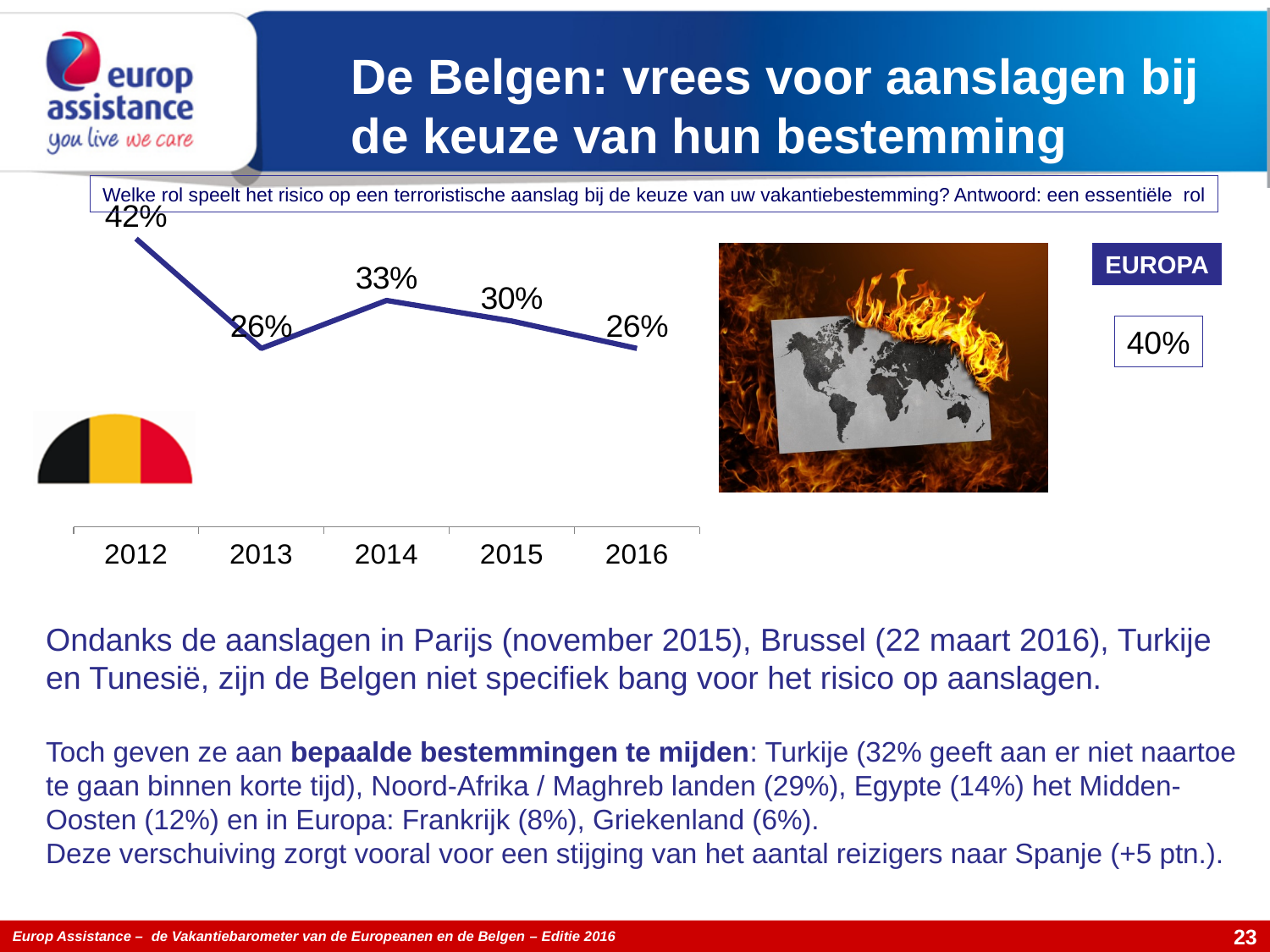
Which is larger, the value for 2014 or the value for 2015? 2014 Does the value rise or fall from 2012 to 2013? fall How many years are plotted on the x axis? 5 What is the difference between the values for 2014 and 2015? 3% Does the value rise or fall from 2013 to 2014? rise Which year has the highest value? 2012 What value is shown in the box under the EUROPA label? 40% What type of chart is shown on the slide? line chart What is the difference between the values for 2012 and 2013? 16% What is the value for 2016? 26% What is the value for 2014? 33% What is the value for 2012? 42%